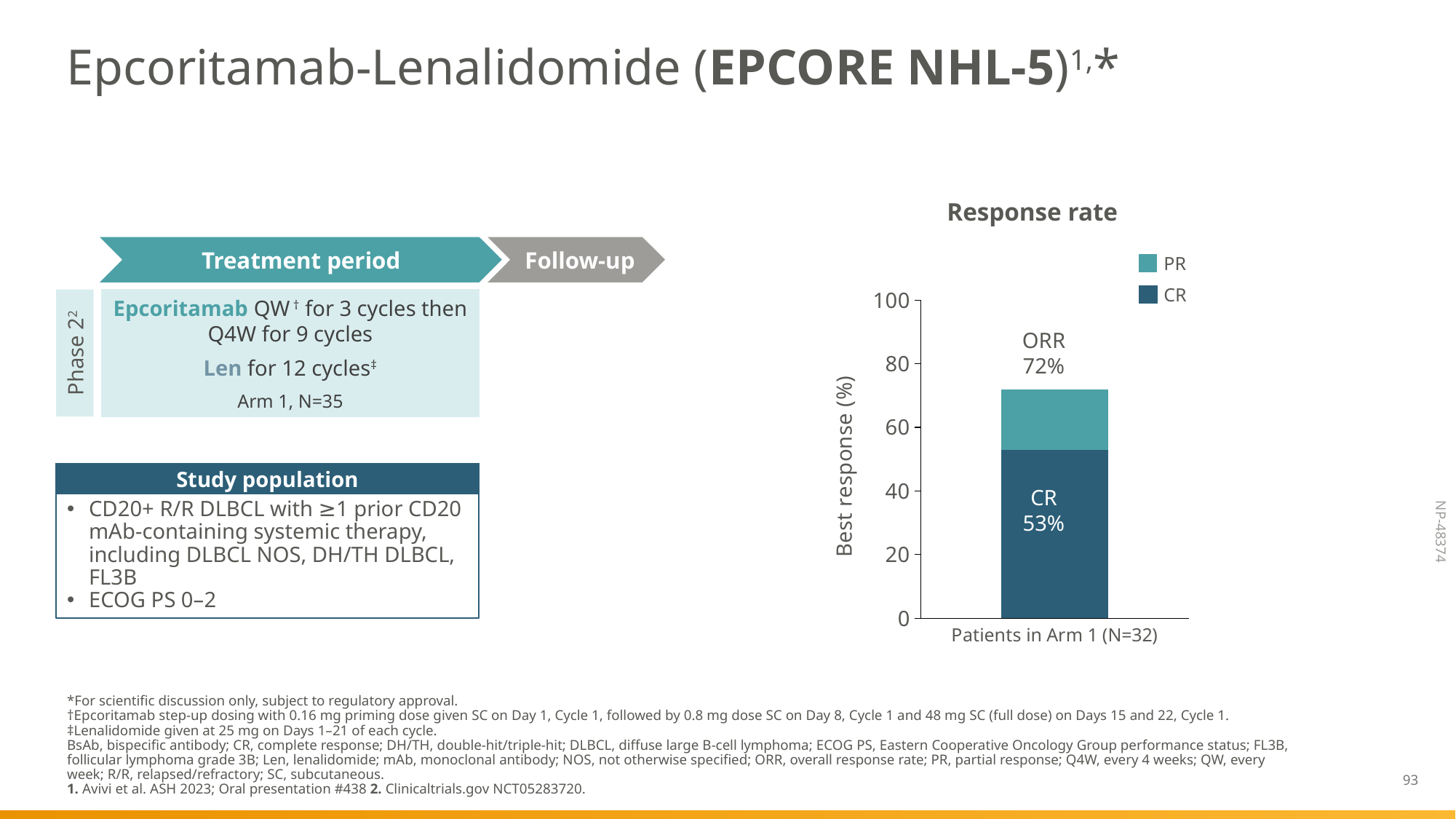
What is the category label on the x axis of the Response rate chart? Patients in Arm 1 (N=32) In the Response rate chart, which is larger, the CR segment or the PR segment? CR What is the CR value shown in the Response rate chart? 53% What is the title of the chart on the slide? Response rate What type of chart is shown under the title "Response rate"? bar chart How many bars are plotted in the Response rate chart? 1 What is the difference between the ORR and the CR value in the Response rate chart? 19% What is the ORR value shown above the bar in the Response rate chart? 72% Is the CR value in the Response rate chart greater or less than 60? less Is the total height of the bar in the Response rate chart greater or less than 80? less What is the total height of the stacked bar in the Response rate chart? 72% How many series does the legend of the Response rate chart list? 2